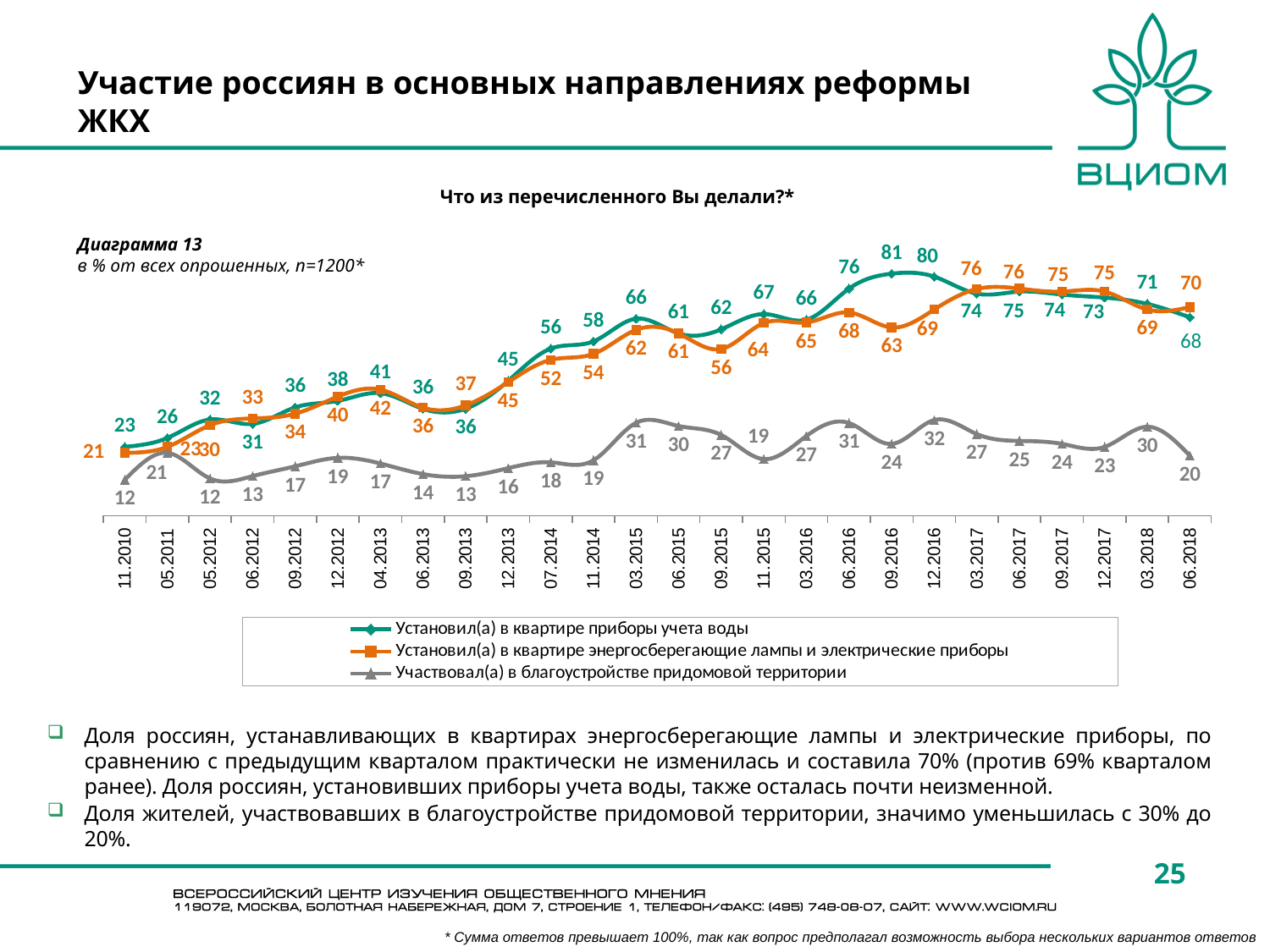
How many time points are shown on the x axis? 26 What is the highest value of 'Установил(а) в квартире приборы учета воды'? 81 In 06.2018, which is larger: the value for water meters or the value for energy-saving lamps and electrical appliances? energy-saving lamps and electrical appliances In which period does 'Установил(а) в квартире приборы учета воды' reach its highest value? 09.2016 What is the question shown as the chart's title? Что из перечисленного Вы делали?* What is the value for 'Участвовал(а) в благоустройстве придомовой территории' in 06.2018? 20 Does the value for 'Участвовал(а) в благоустройстве придомовой территории' rise or fall from 03.2018 to 06.2018? fall How many series does the legend list? 3 What kind of chart is shown on the slide? line chart What is the value for 'Установил(а) в квартире приборы учета воды' in 06.2018? 68 By how much did 'Участвовал(а) в благоустройстве придомовой территории' change from 03.2018 to 06.2018? 10 What is the value for 'Установил(а) в квартире энергосберегающие лампы и электрические приборы' in 06.2018? 70